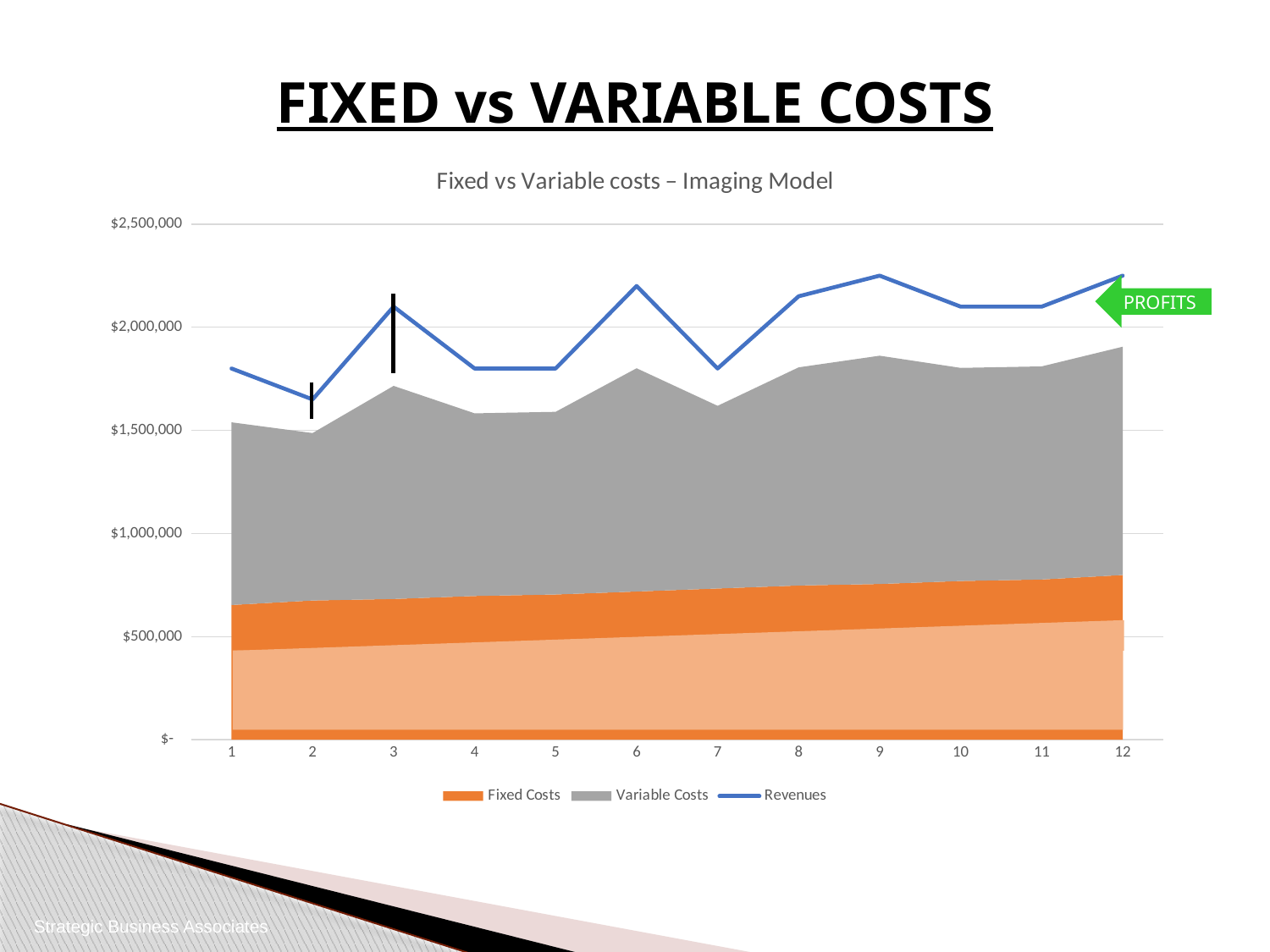
What kind of chart is this? Stacked area chart with a line Is the Revenues value at period 2 greater or less than $1,500,000? greater How many series does the legend list? 3 Is the Revenues value at period 4 greater or less than $2,000,000? less Is the Revenues value at period 9 greater or less than $2,000,000? greater Do the Fixed Costs rise or fall from period 1 to period 12? Rise Which is larger, the Revenues value at period 6 or at period 7? Period 6 At which period is the Revenues line lowest? 2 Which series is drawn as a blue line? Revenues What is the title of the chart? Fixed vs Variable costs – Imaging Model How many periods are shown along the x axis? 12